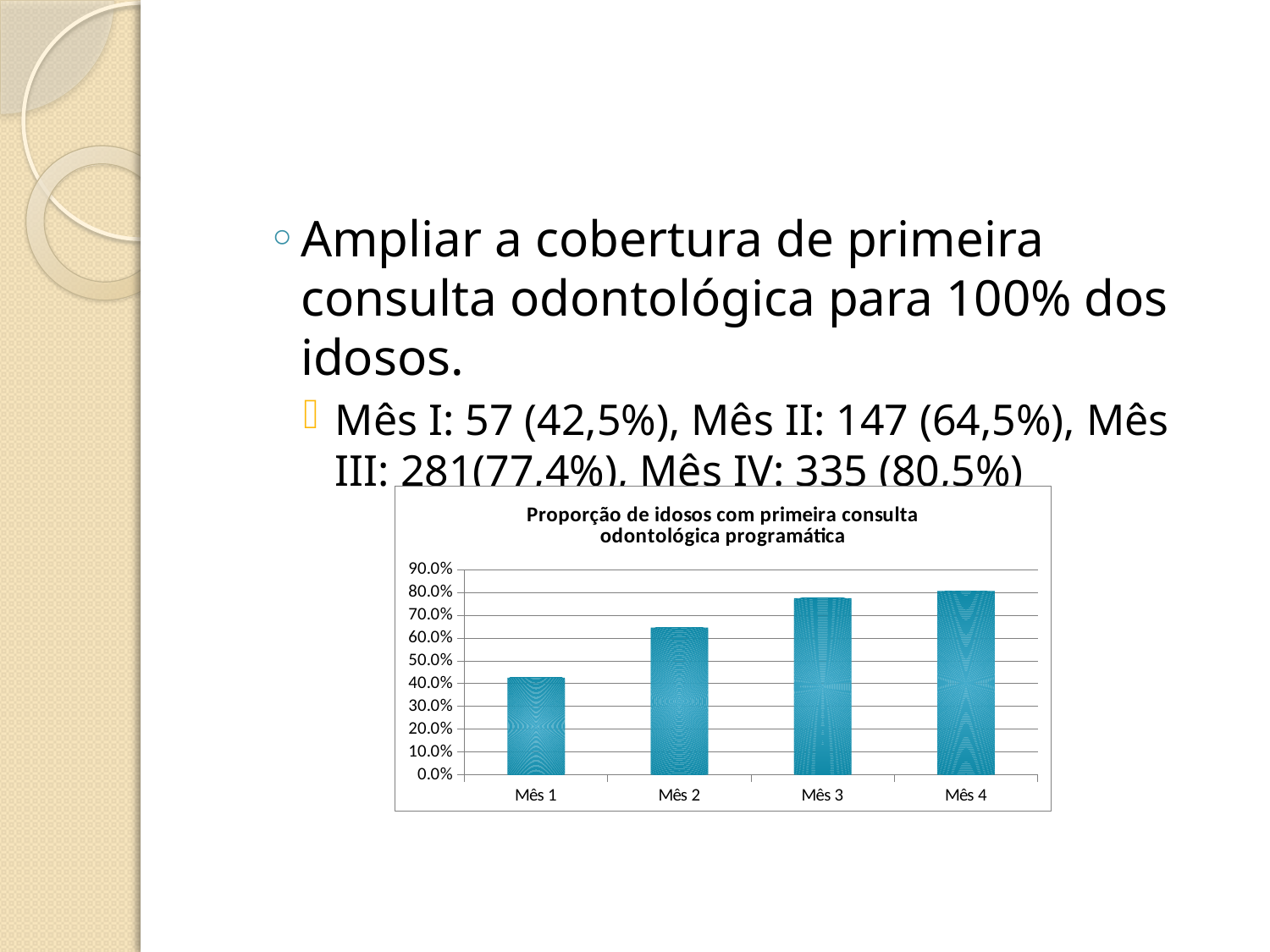
What kind of chart is shown on the slide? bar chart Is the value for Mês 3 greater or less than 70.0%? greater Which is larger, the value for Mês 2 or the value for Mês 3? Mês 3 Which category has the highest bar in the chart? Mês 4 Is the value for Mês 1 greater or less than 50.0%? less Do the values rise or fall from Mês 1 to Mês 4? rise What is the highest value shown on the y axis of the chart? 90.0% Is the value for Mês 4 greater or less than 90.0%? less Which category has the lowest bar in the chart? Mês 1 How many categories are shown on the x axis of the chart? 4 What is the title of the chart? Proporção de idosos com primeira consulta odontológica programática